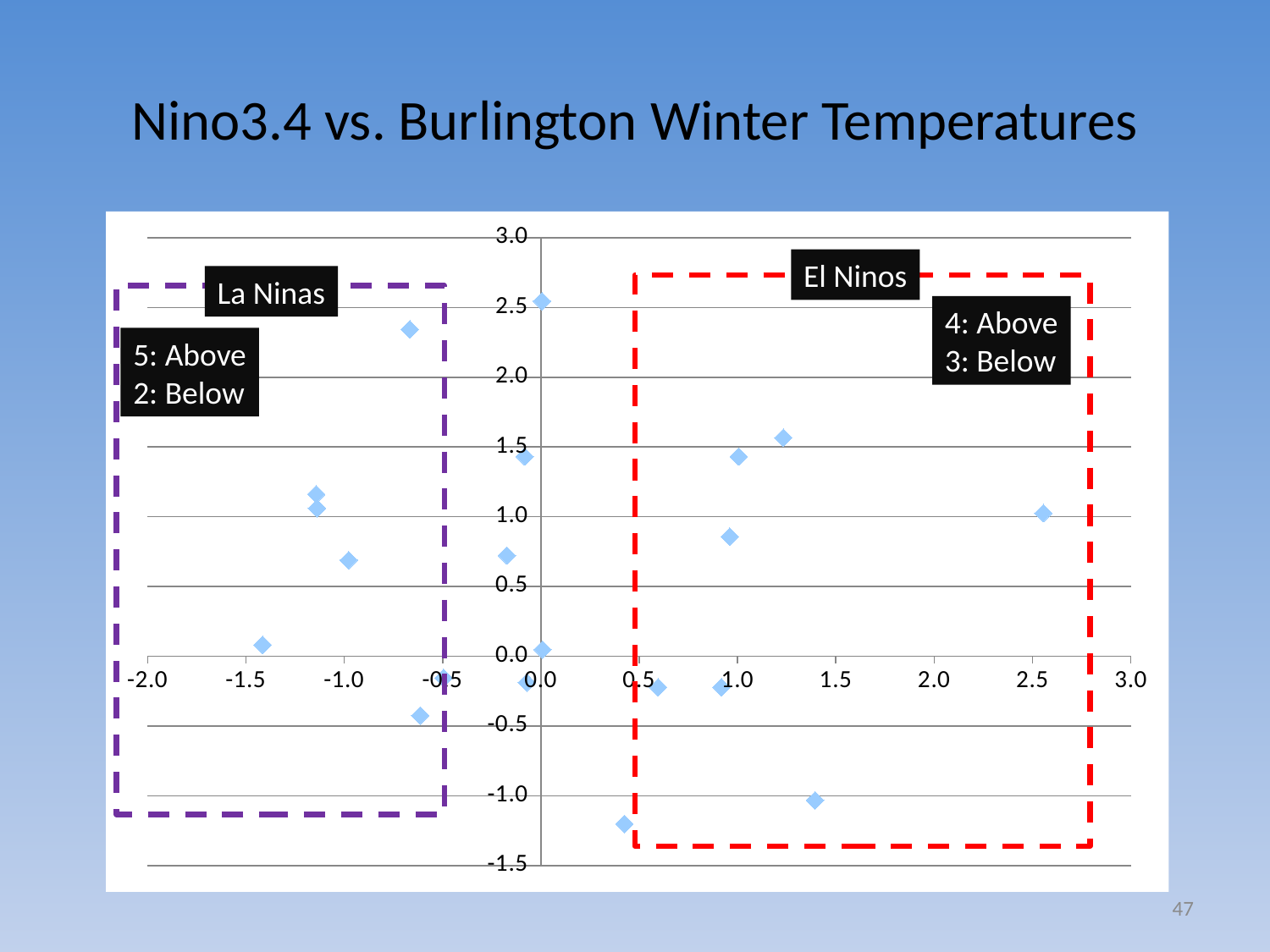
What is the maximum value shown on the x axis? 3.0 Which group is enclosed by the purple dashed box? La Ninas According to the annotation in the La Ninas box, how many La Nina winters were above and how many below? 5: Above, 2: Below What is the minimum value shown on the y axis? -1.5 Is the y value of the highest point inside the La Ninas box greater or less than 2.0? greater What is the title of the chart? Nino3.4 vs. Burlington Winter Temperatures According to the annotation in the El Ninos box, how many El Nino winters were above and how many below? 4: Above, 3: Below Is the x value of the rightmost point on the chart greater or less than 2.0? greater What kind of chart is shown on the slide? scatter chart Is the y value of the rightmost point on the chart greater or less than 0.5? greater